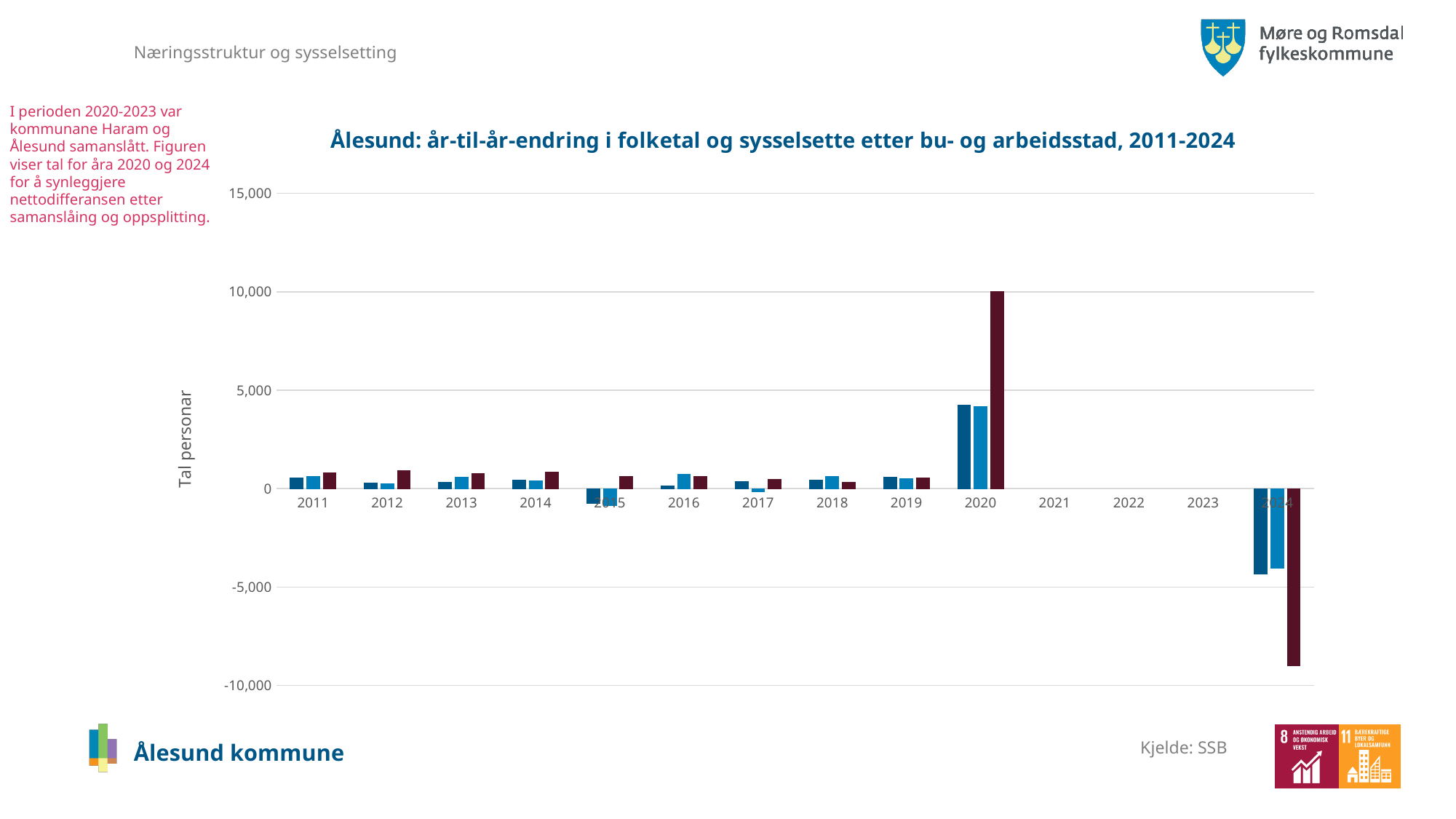
How many years on the x axis have no visible bars? 3 Which year has the tallest bar in the chart? 2020 Is the value of the dark blue bar for 2020 greater or less than 5,000? less Is the value of the dark red bar for 2020 greater or less than 5,000? greater Which year has the larger dark red bar, 2019 or 2020? 2020 What kind of chart is shown on the slide? bar chart How many years are shown on the x axis of the chart? 14 Is the value of the dark blue bar for 2024 greater or less than -5,000? greater What is the title of the chart? Ålesund: år-til-år-endring i folketal og sysselsette etter bu- og arbeidsstad, 2011-2024 Which year has the lowest (most negative) bar in the chart? 2024 What is the label on the vertical axis of the chart? Tal personar